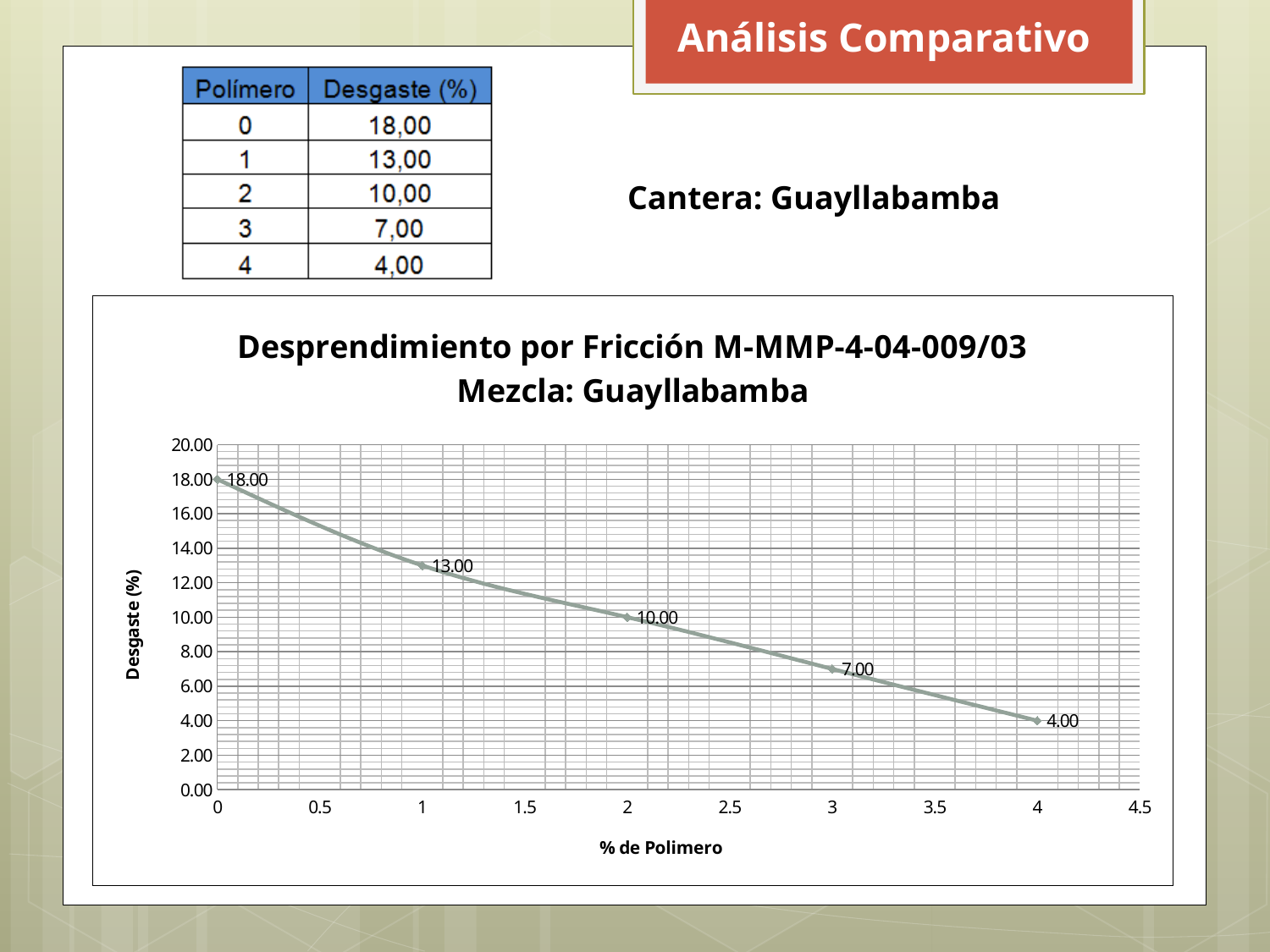
What is the Desgaste (%) value at 4% de Polimero? 4.00 What is the difference in Desgaste (%) between 0% and 1% de Polimero? 5.00 What is the difference in Desgaste (%) between 3% and 4% de Polimero? 3.00 Which has a larger Desgaste (%) value: 1% de Polimero or 3% de Polimero? 1% de Polimero What is the Desgaste (%) value at 2% de Polimero? 10.00 What is the label of the y axis of the chart? Desgaste (%) At which % de Polimero is the Desgaste (%) lowest? 4 Does the Desgaste (%) rise or fall as % de Polimero increases? Fall How many data points are plotted on the chart? 5 What is the Desgaste (%) value at 0% de Polimero? 18.00 What kind of chart is shown on the slide? Line chart At which % de Polimero is the Desgaste (%) highest? 0